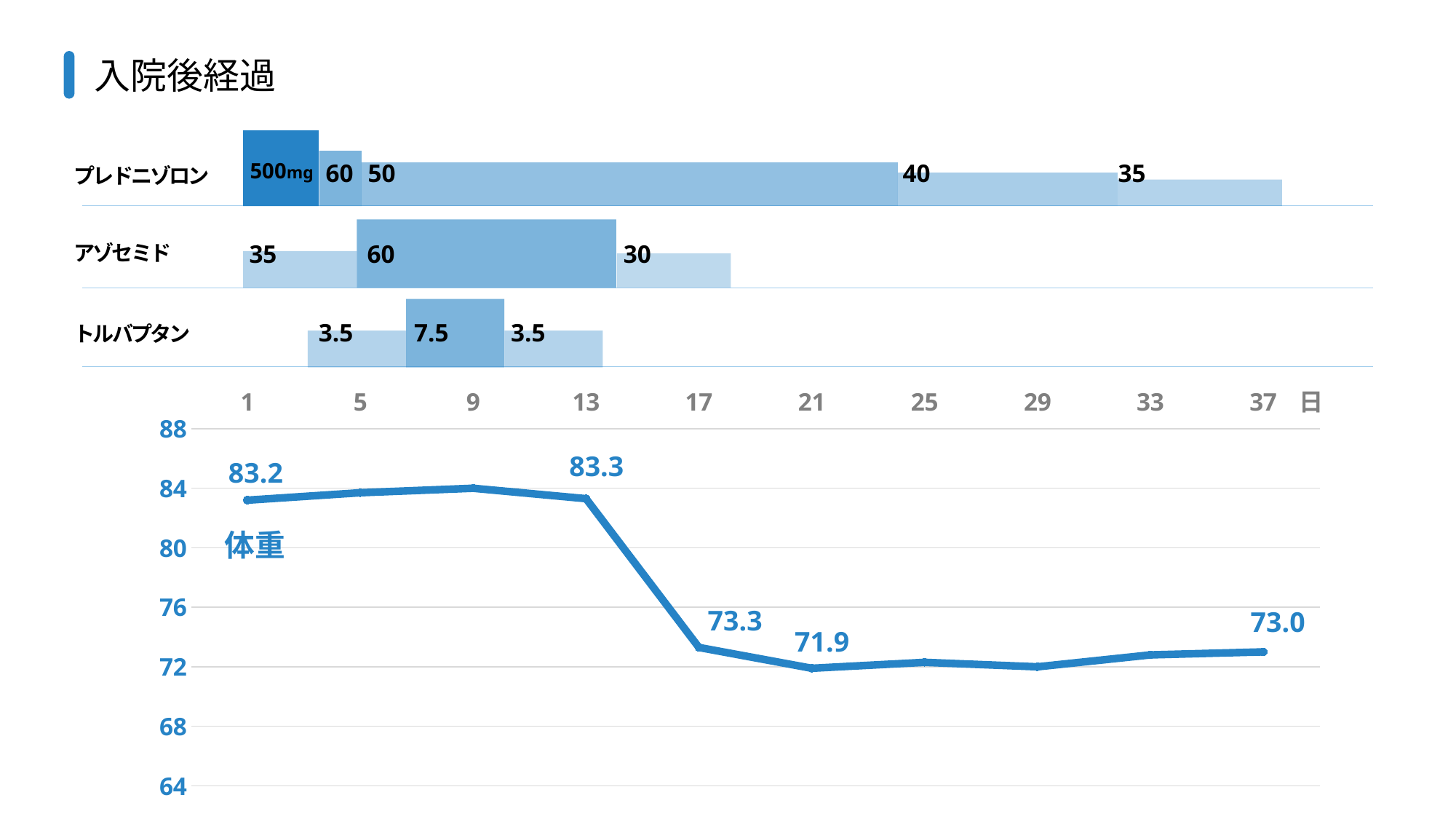
In the bottom line chart, does the body weight rise or fall between day 13 and day 17? fall In the bottom line chart, what is the body weight (体重) value labelled at day 1? 83.2 In the bottom line chart, is the body weight at day 29 greater or less than 76? less In the bottom line chart, what is the body weight value labelled at day 37? 73.0 In the top medication chart, what is the highest dose shown for アゾセミド? 60 In the bottom line chart, which labelled body weight value is the lowest? 71.9 What kind of chart is the body weight (体重) chart at the bottom of the slide? line chart In the bottom line chart, what is the body weight value labelled at day 21? 71.9 How many medications are listed in the top medication chart? 3 In the top medication chart, what is the middle (highest) dose shown for トルバプタン? 7.5 In the bottom line chart, what is the difference between the body weight at day 1 (83.2) and at day 37 (73.0)? 10.2 In the top medication chart, what is the first dose shown for プレドニゾロン? 500mg